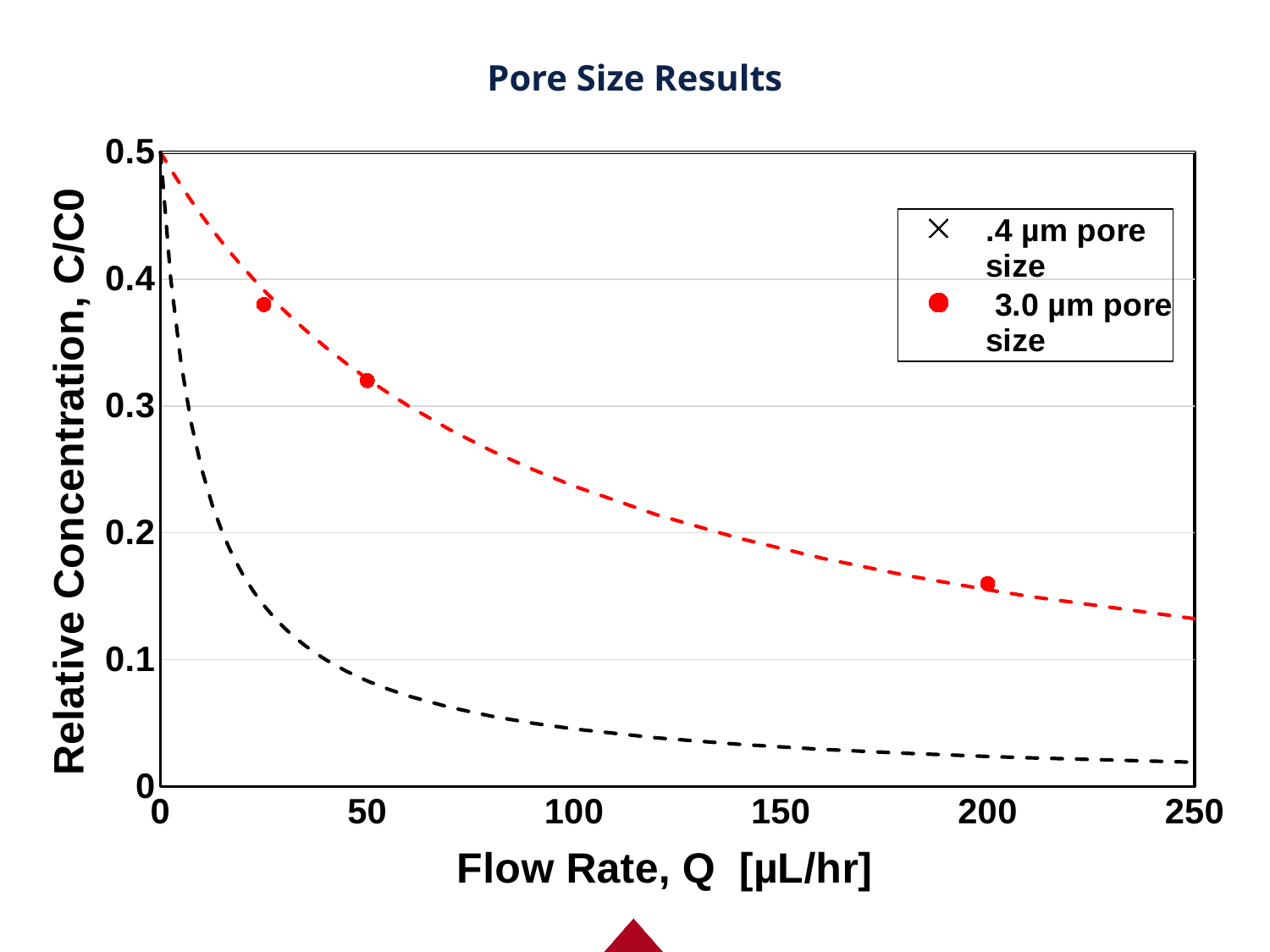
What kind of chart is shown on the slide? Scatter chart Is the relative concentration for the 3.0 µm pore size at a flow rate of 200 µL/hr greater or less than 0.2? less Is the .4 µm pore size dashed curve at a flow rate of 100 µL/hr greater or less than 0.1? less What is the title of the chart? Pore Size Results What is the label of the x axis? Flow Rate, Q [µL/hr] Which series has the lowest relative concentration at a flow rate of 250 µL/hr? .4 µm pore size How many red data points are plotted for the 3.0 µm pore size series? 3 Is the relative concentration for the 3.0 µm pore size at a flow rate of 50 µL/hr greater or less than 0.4? less How many series does the legend list? 2 Does the relative concentration for the 3.0 µm pore size rise or fall as flow rate increases? Fall Which series has the higher relative concentration at a flow rate of 100 µL/hr, the .4 µm pore size or the 3.0 µm pore size? 3.0 µm pore size